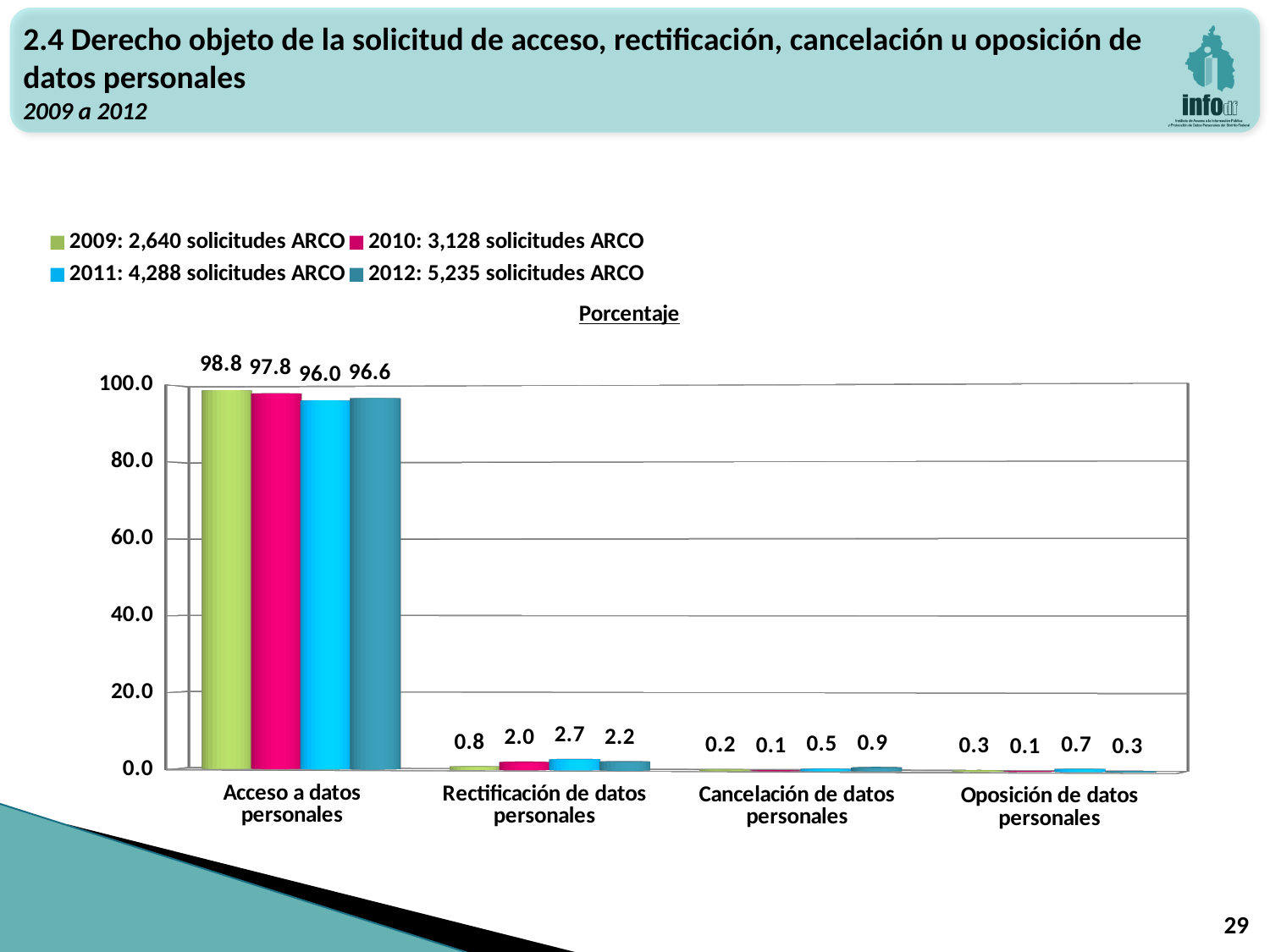
How many categories are shown on the x axis? 4 What is the value for 'Cancelación de datos personales' in the 2012 series? 0.9 What is the difference between the 2009 and 2011 values for 'Acceso a datos personales'? 2.8 Which category has the highest value in the 2012 series? Acceso a datos personales Which category has the lowest value in the 2009 series? Cancelación de datos personales What is the value for 'Oposición de datos personales' in the 2010 series? 0.1 Which is larger for 'Rectificación de datos personales': the 2010 value or the 2012 value? 2012 What is the value for 'Rectificación de datos personales' in the 2011 series? 2.7 How many series does the legend list? 4 What is the title shown above the chart? Porcentaje What is the value for 'Acceso a datos personales' in the 2009 series? 98.8 What kind of chart is shown on the slide? Bar chart